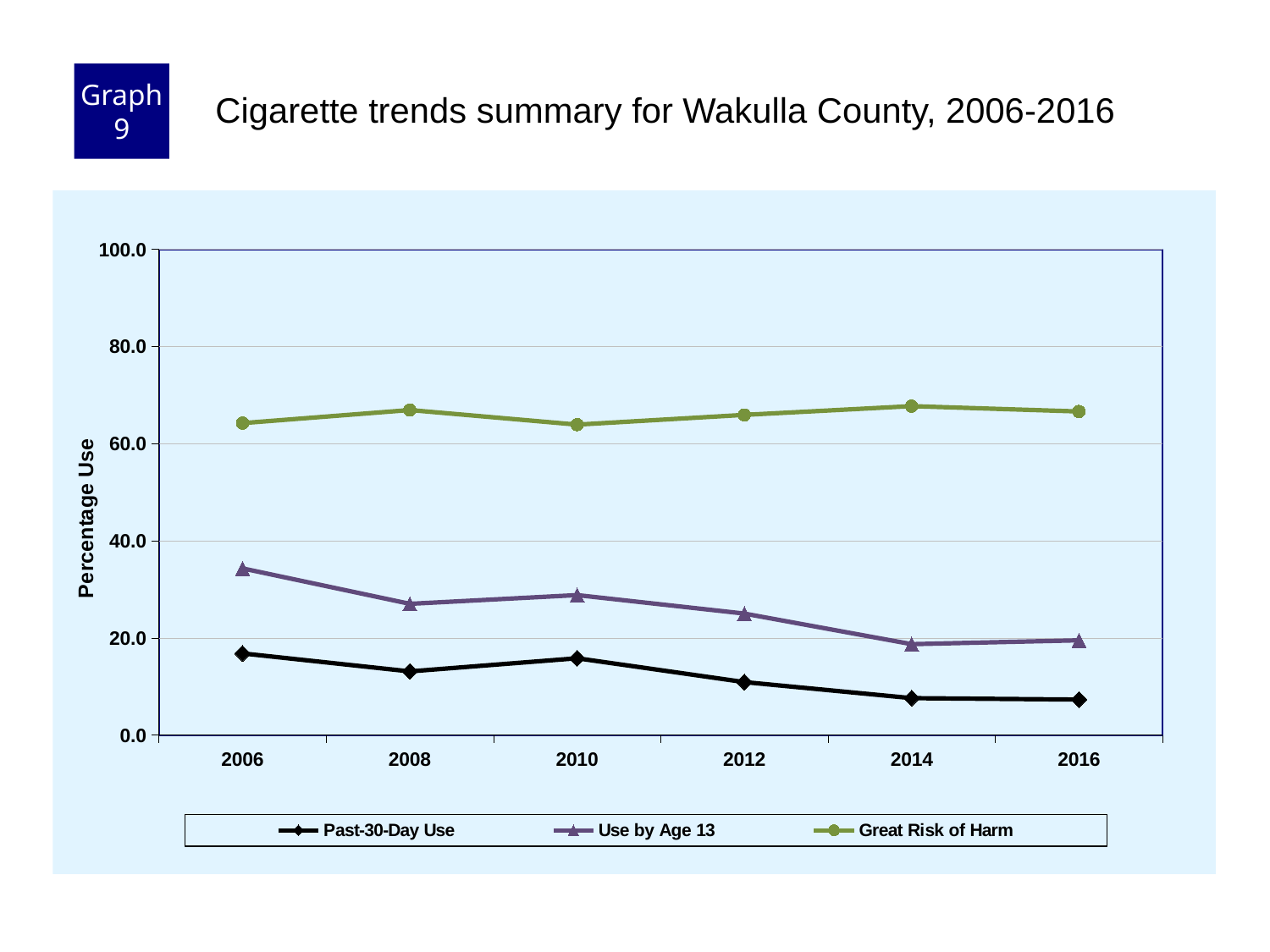
Is the value for Past-30-Day Use in 2016 greater or less than 20.0? less Which is larger for Use by Age 13: the value in 2006 or the value in 2008? 2006 Is the value for Great Risk of Harm in 2014 greater or less than 60.0? greater In which year is Use by Age 13 highest? 2006 What is the label on the y axis? Percentage Use What kind of chart is shown on the slide? Line chart Does Past-30-Day Use generally rise or fall from 2006 to 2016? Fall How many years are plotted along the x axis? 6 How many series does the legend list? 3 In 2016, which series has the larger value: Great Risk of Harm or Use by Age 13? Great Risk of Harm Is the value for Use by Age 13 in 2006 greater or less than 40.0? less